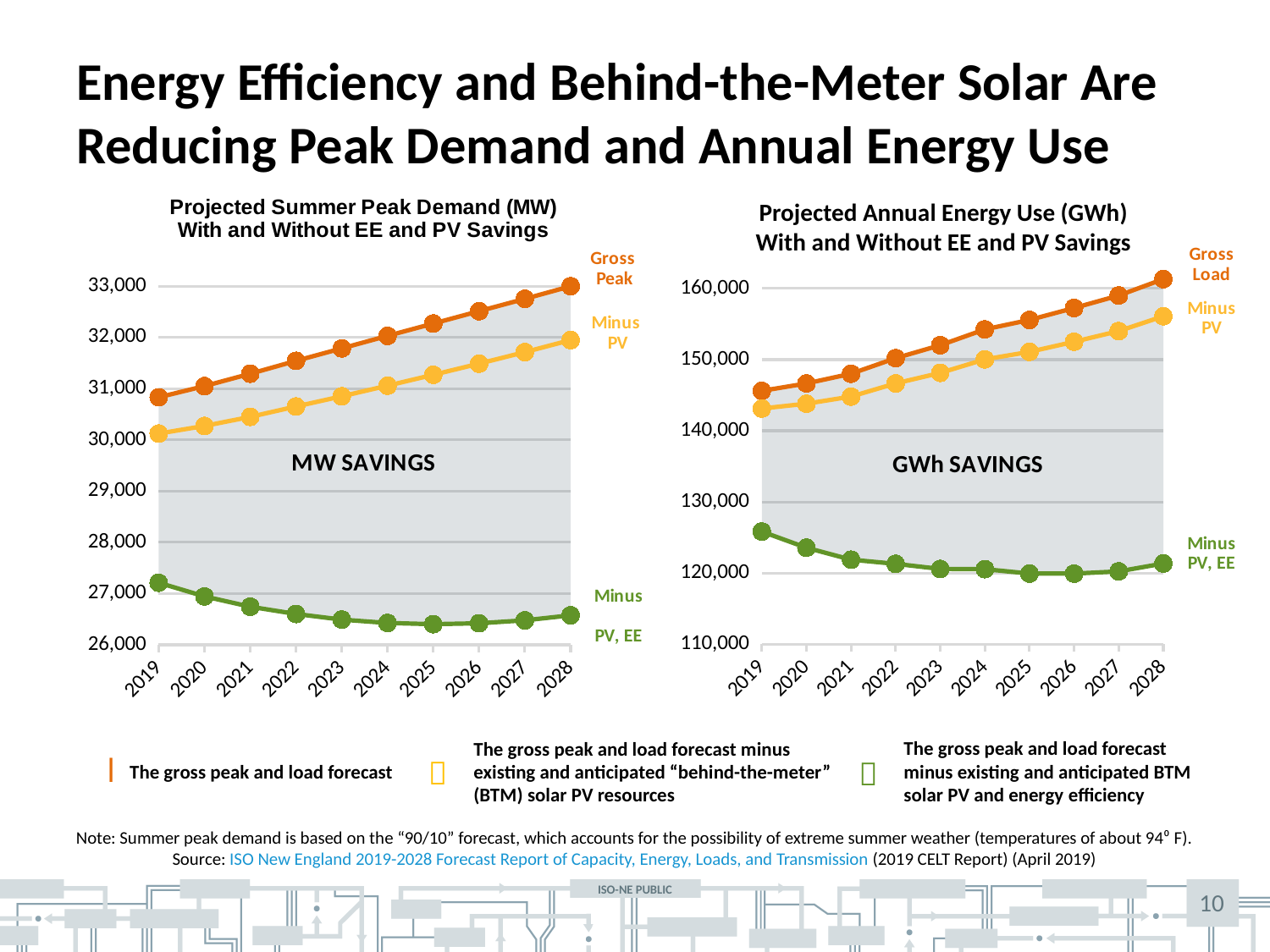
How many series are shown in the Projected Summer Peak Demand (MW) chart? 3 What label is printed in the shaded area of the Projected Summer Peak Demand (MW) chart? MW SAVINGS In the Projected Annual Energy Use (GWh) chart, which is larger in 2028: Gross Load or Minus PV? Gross Load In the Projected Summer Peak Demand (MW) chart, is the Minus PV, EE value for 2025 greater or less than 27,000? less In the Projected Annual Energy Use (GWh) chart, is the Minus PV, EE value for 2025 greater or less than 130,000? less In the Projected Summer Peak Demand (MW) chart, is the Minus PV, EE value in 2028 higher or lower than in 2019? lower In the Projected Annual Energy Use (GWh) chart, is the Minus PV value for 2019 greater or less than 150,000? less What kind of chart is the Projected Summer Peak Demand (MW) chart on the left? Line chart In the Projected Annual Energy Use (GWh) chart, which year has the highest Gross Load value? 2028 How many years are plotted on the x axis of the Projected Annual Energy Use (GWh) chart? 10 In the Projected Summer Peak Demand (MW) chart, does the Gross Peak line rise or fall from 2019 to 2028? rise